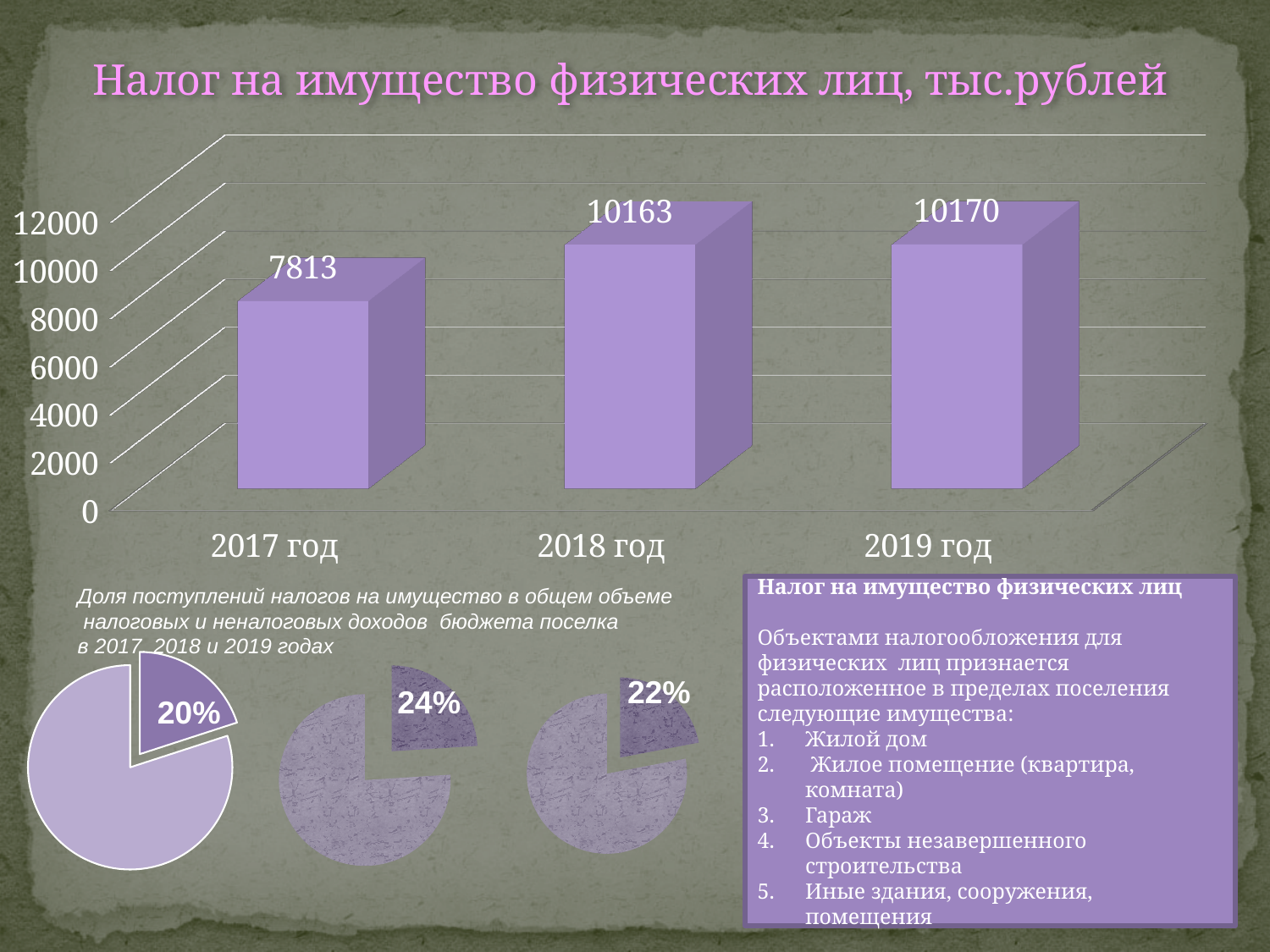
In the bar chart 'Налог на имущество физических лиц, тыс.рублей', what is the value for 2018 год? 10163 In the bar chart 'Налог на имущество физических лиц, тыс.рублей', what is the difference between the values for 2018 год and 2017 год? 2350 In the bar chart 'Налог на имущество физических лиц, тыс.рублей', what is the value for 2017 год? 7813 In the middle pie chart at the bottom of the slide, what share is labelled on the highlighted slice? 24% In the leftmost pie chart at the bottom of the slide, what share is labelled on the highlighted slice? 20% In the bar chart 'Налог на имущество физических лиц, тыс.рублей', do the values rise or fall from 2017 год to 2019 год? rise In the bar chart 'Налог на имущество физических лиц, тыс.рублей', how many years are shown? 3 In the bar chart 'Налог на имущество физических лиц, тыс.рублей', which year has the lowest value? 2017 год What kind of chart is the top chart titled 'Налог на имущество физических лиц, тыс.рублей'? bar chart In the bar chart 'Налог на имущество физических лиц, тыс.рублей', is the value for 2017 год greater or less than 8000? less In the bar chart 'Налог на имущество физических лиц, тыс.рублей', what is the value for 2019 год? 10170 In the bar chart 'Налог на имущество физических лиц, тыс.рублей', which year has the highest value? 2019 год